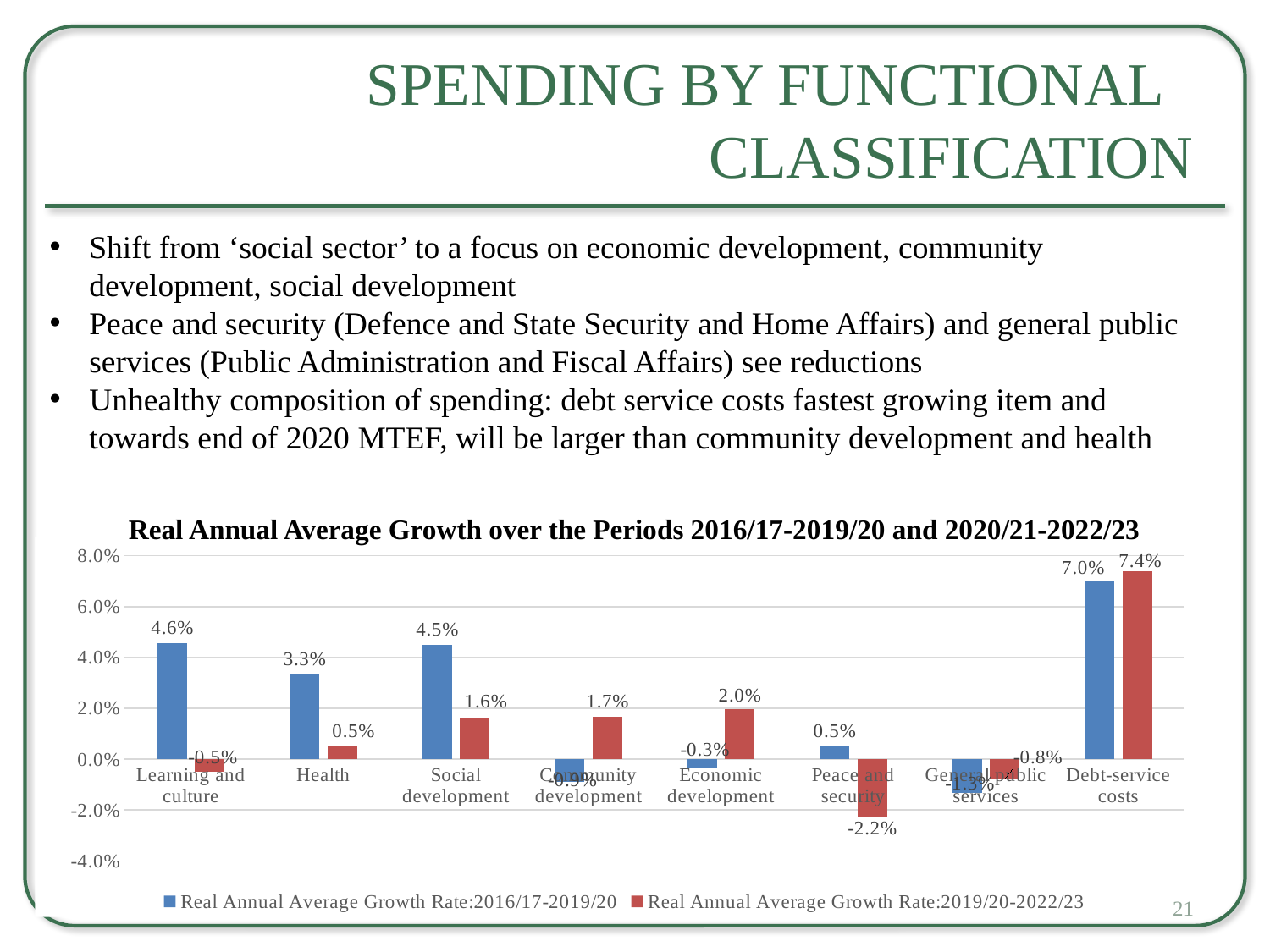
What is the Real Annual Average Growth Rate for Economic development in 2019/20-2022/23? 2.0% What is the difference between the 2016/17-2019/20 growth rates for Learning and culture and Health? 1.3 percentage points What is the Real Annual Average Growth Rate for Debt-service costs in 2016/17-2019/20? 7.0% What kind of chart is shown on the slide? Bar chart What is the Real Annual Average Growth Rate for Debt-service costs in 2019/20-2022/23? 7.4% Which category has the highest Real Annual Average Growth Rate for 2016/17-2019/20? Debt-service costs Which category has the lowest Real Annual Average Growth Rate for 2019/20-2022/23? Peace and security What is the Real Annual Average Growth Rate for Peace and security in 2016/17-2019/20? 0.5% How many functional categories are shown on the x axis of the chart? 8 What is the title of the chart? Real Annual Average Growth over the Periods 2016/17-2019/20 and 2020/21-2022/23 For 2016/17-2019/20, which has the larger growth rate: Health or Social development? Social development How many series does the chart's legend list? 2